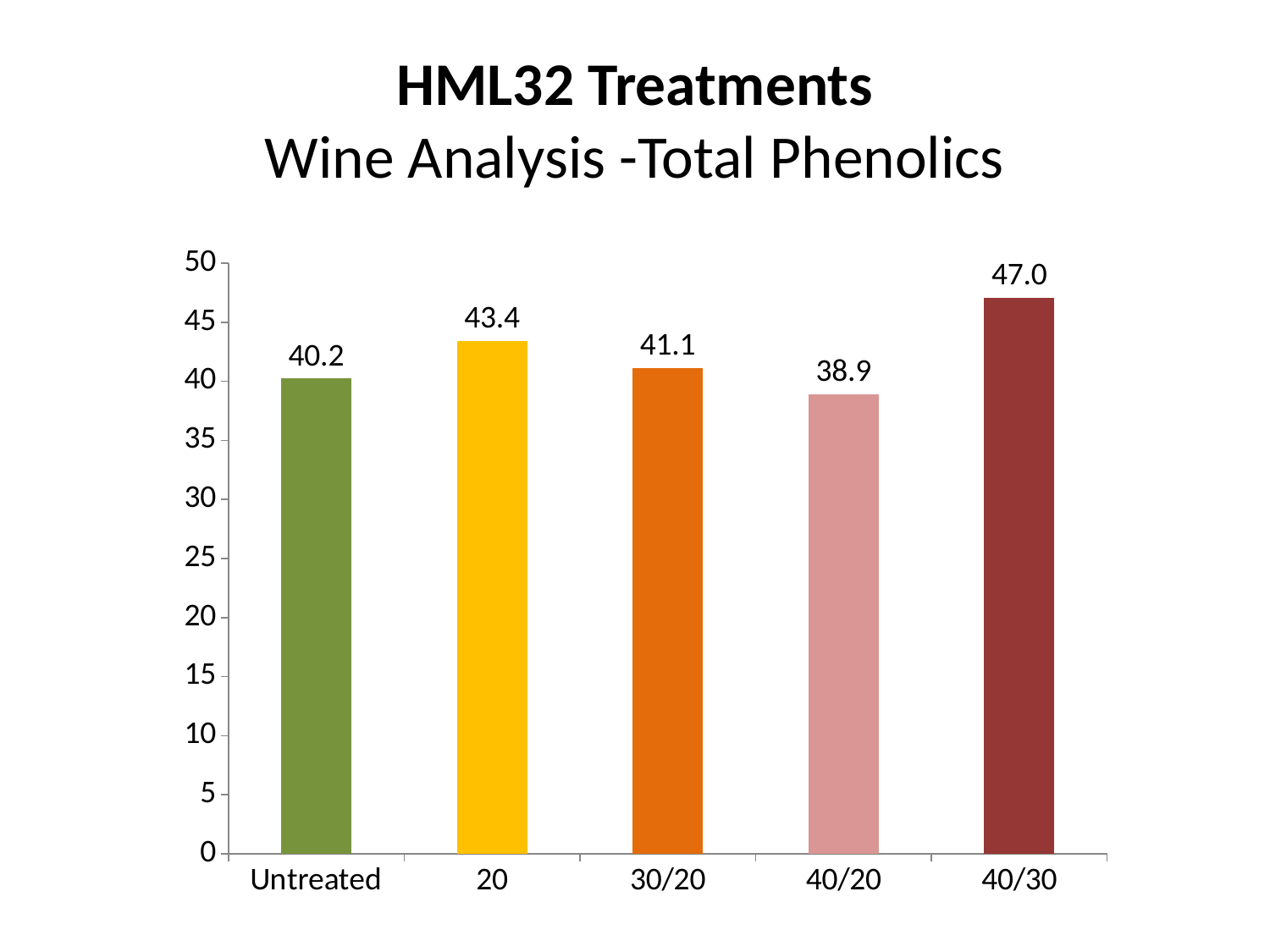
Which treatment has the lowest total phenolics value? 40/20 What is the value shown for the 40/30 treatment? 47.0 What is the value shown for the 40/20 treatment? 38.9 What is the total phenolics value for the Untreated treatment? 40.2 Which treatment has the highest total phenolics value? 40/30 How many treatments are shown on the x axis? 5 What is the difference between the values for 20 and 30/20? 2.3 Is the value for the 40/20 treatment greater or less than 40? less What is the difference between the values for 40/30 and Untreated? 6.8 What kind of chart is shown on the slide? bar chart Which has a larger value, the 20 treatment or the 30/20 treatment? 20 What is the title of the chart? HML32 Treatments Wine Analysis -Total Phenolics